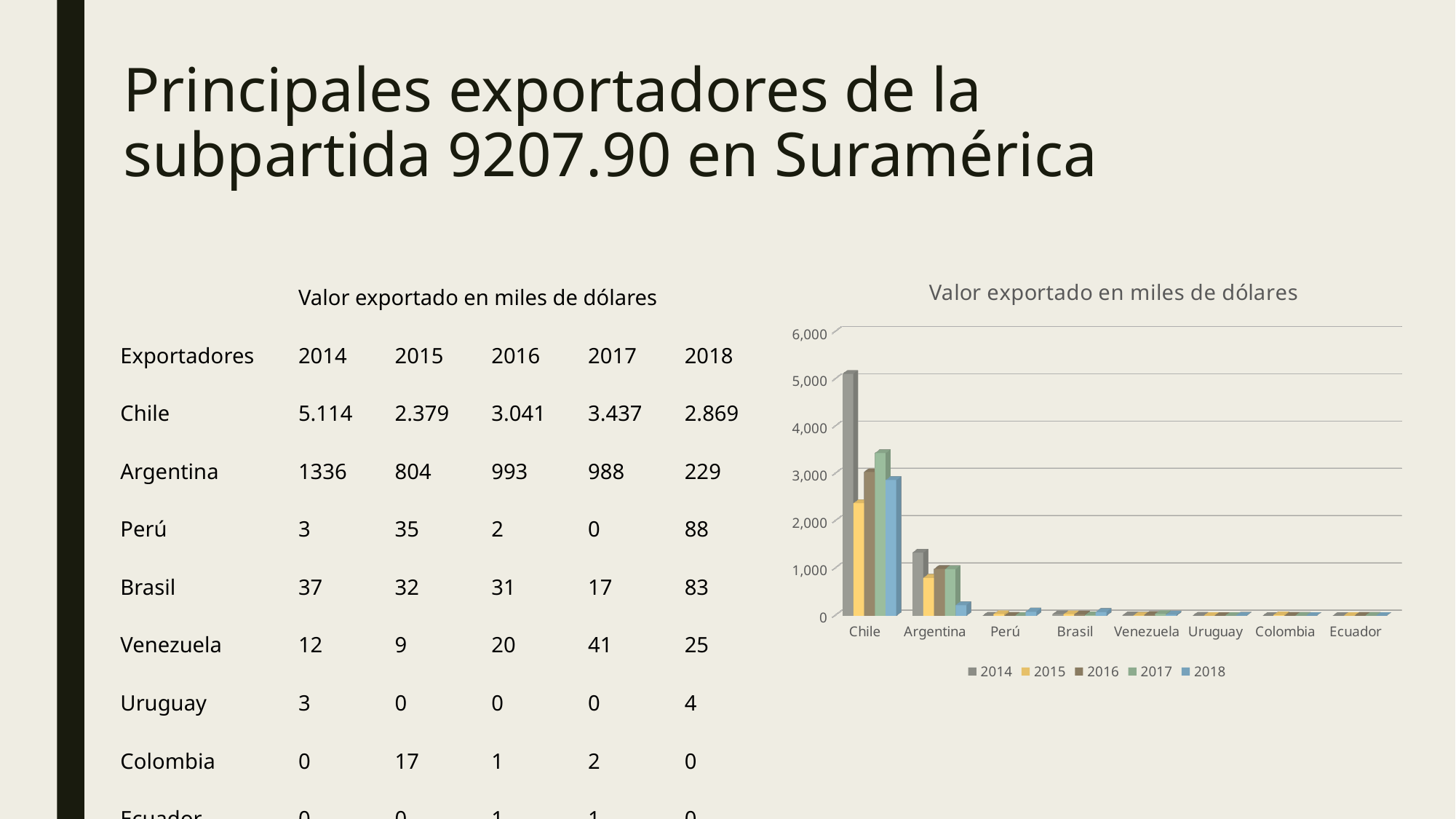
Which is larger for Argentina, the 2014 value or the 2018 value? 2014 Which exporter has the highest bar in the chart? Chile Which is larger for Chile, the 2017 value or the 2016 value? 2017 How many exporter categories are shown on the x axis of the chart? 8 What is the title of the chart? Valor exportado en miles de dólares How many series does the chart legend list? 5 Is the 2014 value for Argentina greater or less than 1,000? greater Is the 2014 value for Chile greater or less than 5,000? greater Is the 2015 value for Chile greater or less than 3,000? less Which series has the tallest bar for Chile? 2014 What is the exported value for Chile in 2014, as printed on the slide? 5.114 What kind of chart is shown on the slide? bar chart